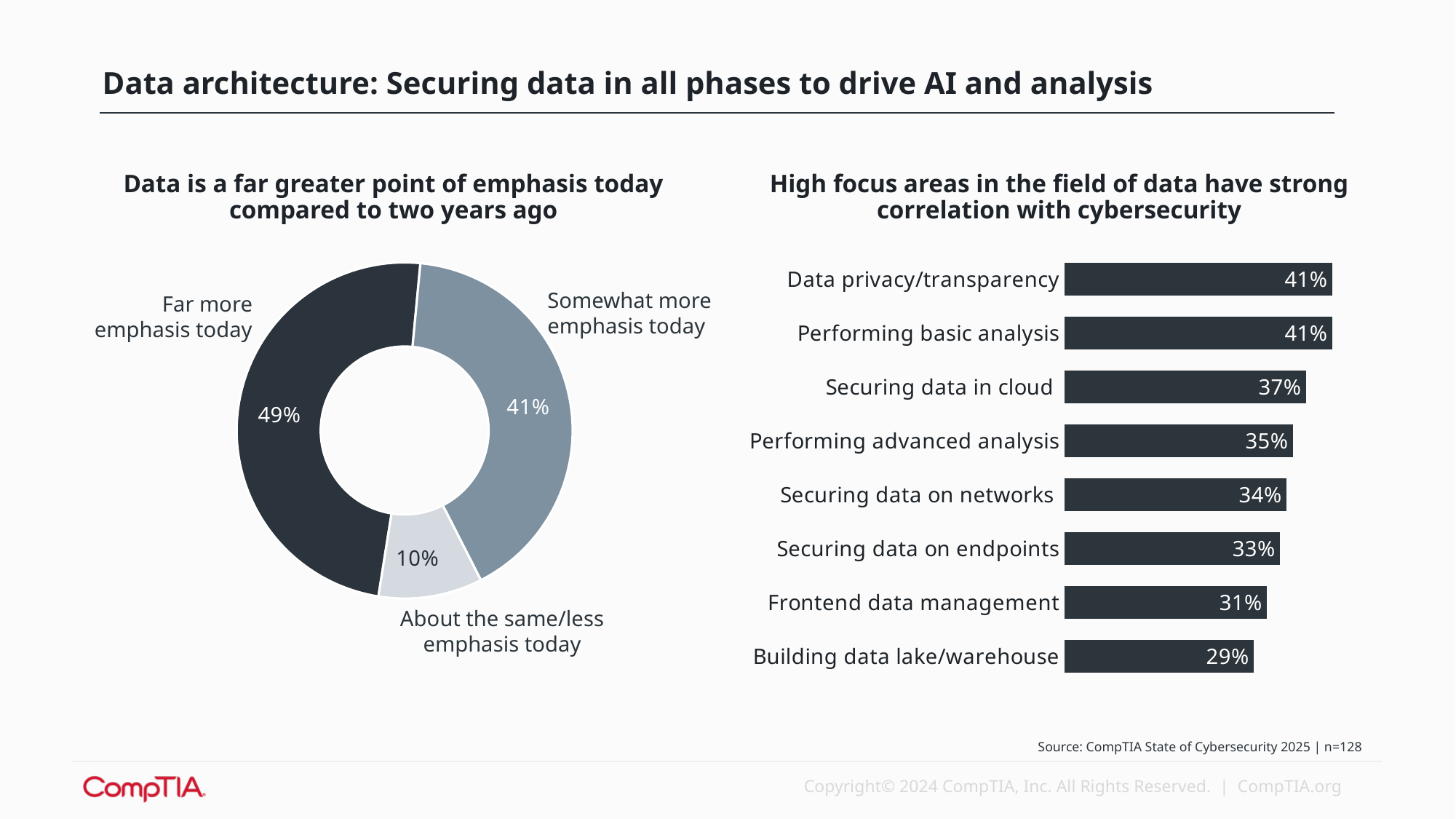
In the left chart titled 'Data is a far greater point of emphasis today compared to two years ago', what kind of chart is shown? Doughnut chart In the right chart titled 'High focus areas in the field of data have strong correlation with cybersecurity', what is the value for 'Frontend data management'? 31% In the right chart titled 'High focus areas in the field of data have strong correlation with cybersecurity', what is the value for 'Securing data in cloud'? 37% In the left chart titled 'Data is a far greater point of emphasis today compared to two years ago', what share is 'Far more emphasis today'? 49% In the right chart titled 'High focus areas in the field of data have strong correlation with cybersecurity', what kind of chart is shown? Bar chart In the left chart titled 'Data is a far greater point of emphasis today compared to two years ago', how many categories are shown? 3 In the left chart titled 'Data is a far greater point of emphasis today compared to two years ago', what share is 'About the same/less emphasis today'? 10% In the right chart titled 'High focus areas in the field of data have strong correlation with cybersecurity', how many categories are shown? 8 In the right chart titled 'High focus areas in the field of data have strong correlation with cybersecurity', which category has the lowest value? Building data lake/warehouse In the right chart titled 'High focus areas in the field of data have strong correlation with cybersecurity', what is the difference between 'Data privacy/transparency' and 'Building data lake/warehouse'? 12% In the right chart titled 'High focus areas in the field of data have strong correlation with cybersecurity', which is larger: 'Securing data on networks' or 'Performing advanced analysis'? Performing advanced analysis In the left chart titled 'Data is a far greater point of emphasis today compared to two years ago', which category has the largest share? Far more emphasis today